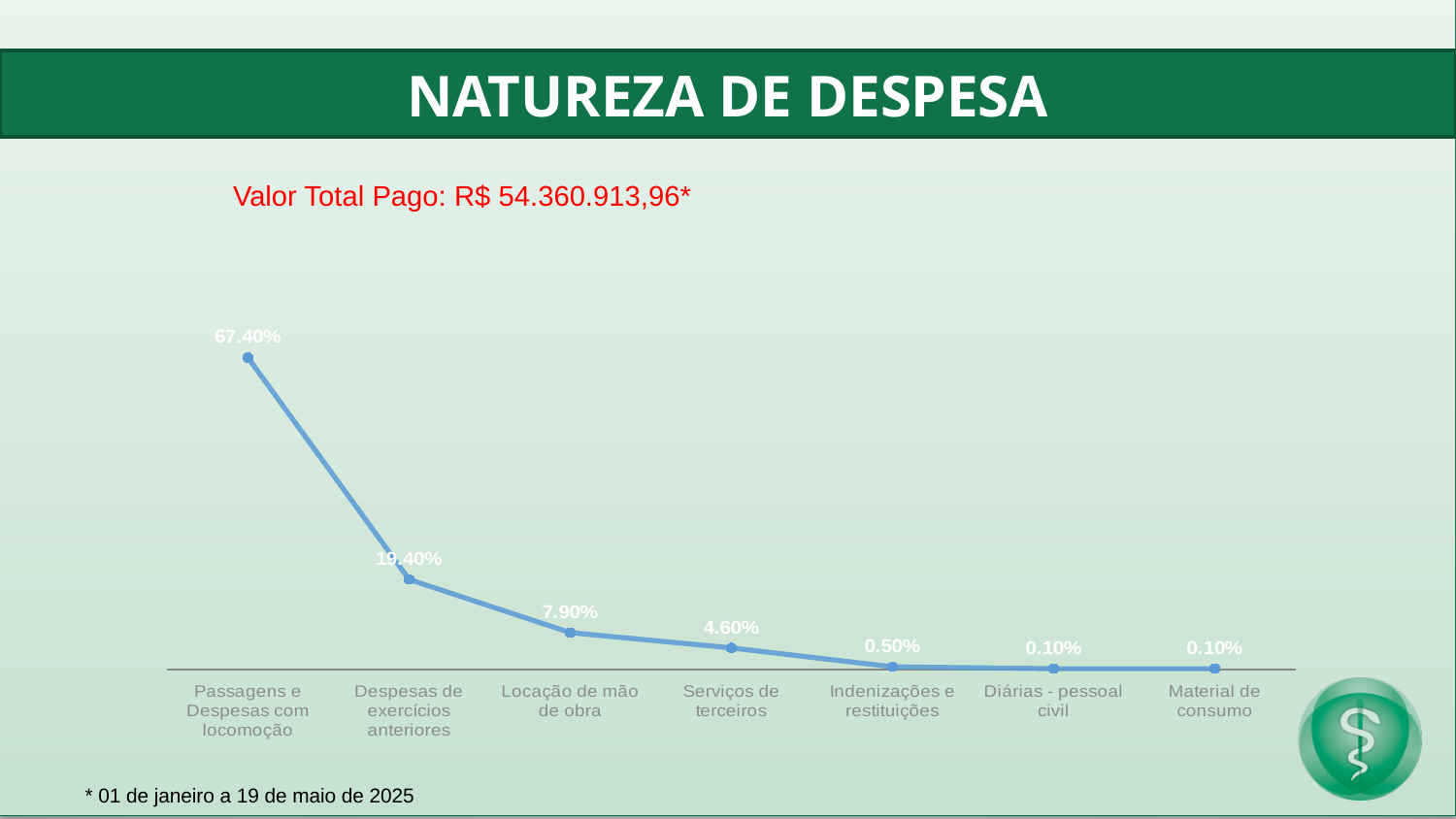
What kind of chart is shown on the slide? line chart Which category has the highest value? Passagens e Despesas com locomoção How many categories are plotted on the x axis? 7 Which is larger, the value for Locação de mão de obra or the value for Serviços de terceiros? Locação de mão de obra What is the title shown above the chart? NATUREZA DE DESPESA What is the value for Locação de mão de obra? 7.90% What is the value for Indenizações e restituições? 0.50% Do the values rise or fall from left to right along the x axis? fall What is the difference between the values for Passagens e Despesas com locomoção and Despesas de exercícios anteriores? 48.00% What is the value for Passagens e Despesas com locomoção? 67.40% What is the value for Despesas de exercícios anteriores? 19.40% What is the value for Serviços de terceiros? 4.60%